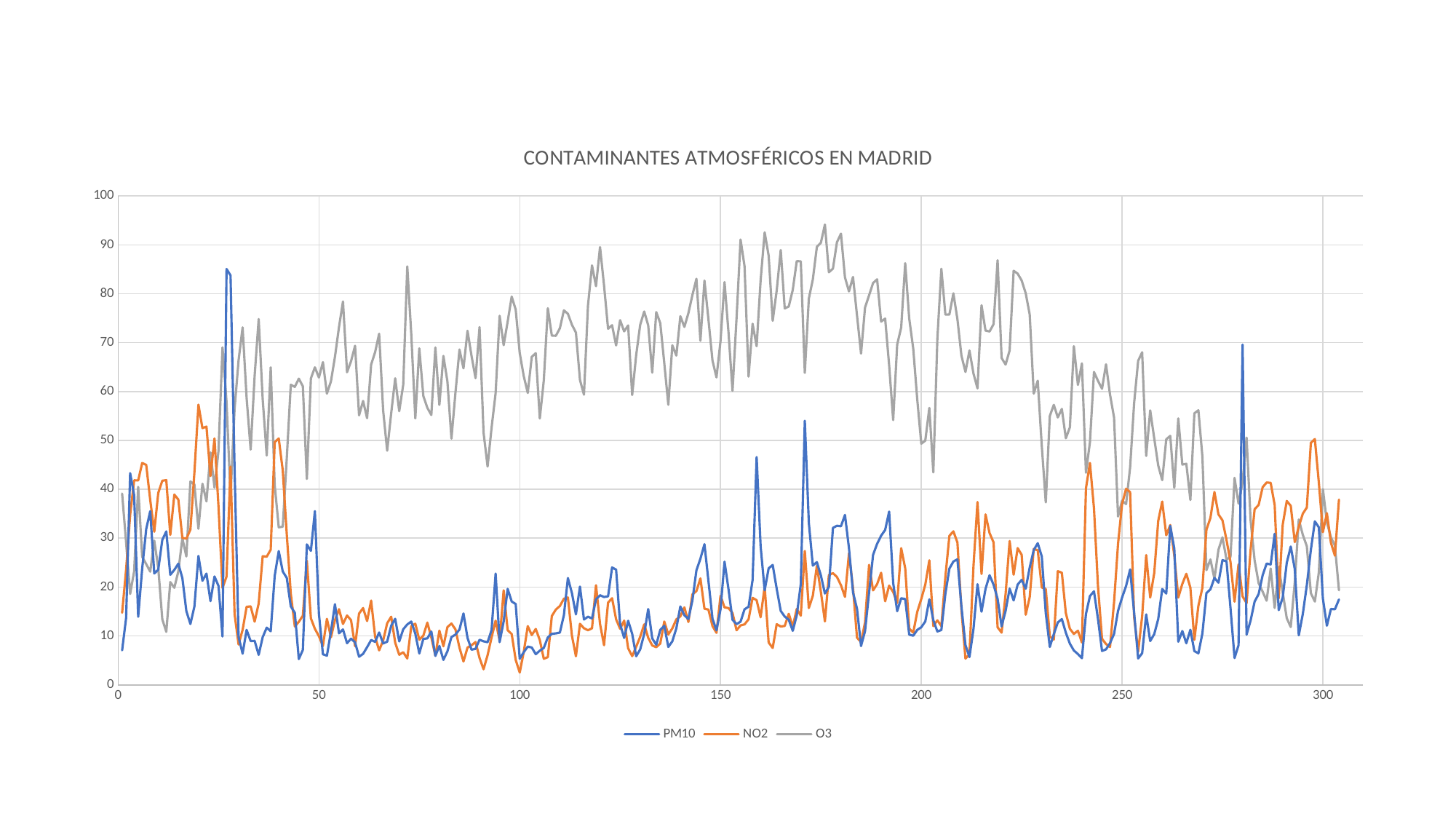
What is the title of the chart? CONTAMINANTES ATMOSFÉRICOS EN MADRID Is the highest value reached by the PM10 series greater or less than 80? greater What kind of chart is shown on the slide? line chart Which series has the highest values over most of the chart? O3 Does the O3 series generally rise or fall between x = 0 and x = 150? rise Is the highest value reached by the O3 series greater or less than 90? greater What is the highest value shown on the vertical axis? 100 Is the highest value reached by the NO2 series greater or less than 60? less Which series is drawn in grey? O3 Does the O3 series generally rise or fall between x = 200 and x = 300? fall Around x = 100, which series is larger, O3 or PM10? O3 How many series does the legend list? 3